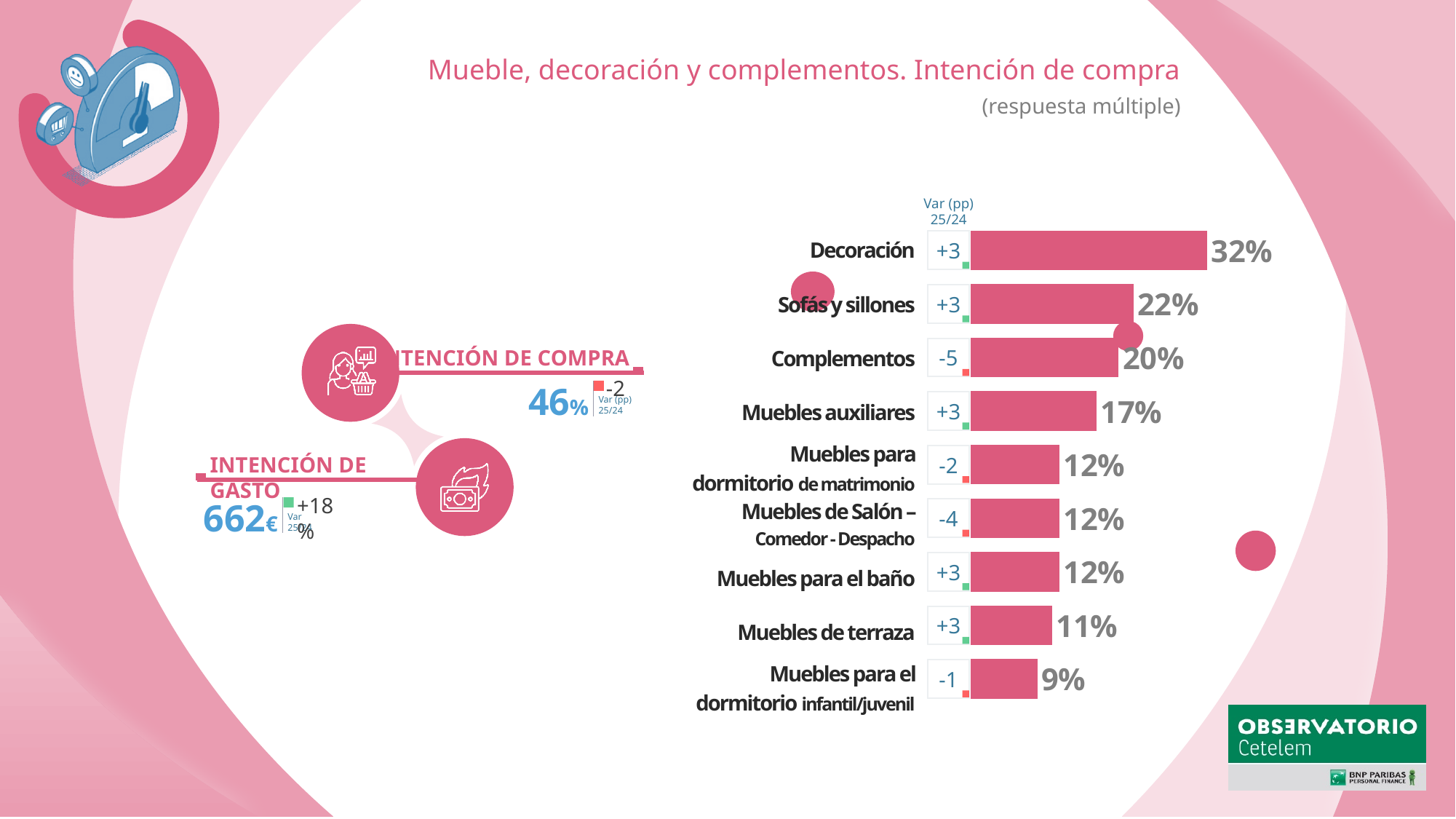
What is the value for Muebles para el dormitorio infantil/juvenil? 9% What is the value shown for Intención de gasto? 662€ How many categories are shown in the bar chart? 9 What is the difference between the values for Decoración and Sofás y sillones? 10 percentage points Which category has the lowest value? Muebles para el dormitorio infantil/juvenil What is the Var (pp) 25/24 value shown for Complementos? -5 Which is larger, the value for Complementos or the value for Muebles de terraza? Complementos What is the value for Muebles auxiliares? 17% What is the title of the slide? Mueble, decoración y complementos. Intención de compra What kind of chart is shown on the slide? Bar chart Which category has the highest value? Decoración What is the value for Decoración? 32%